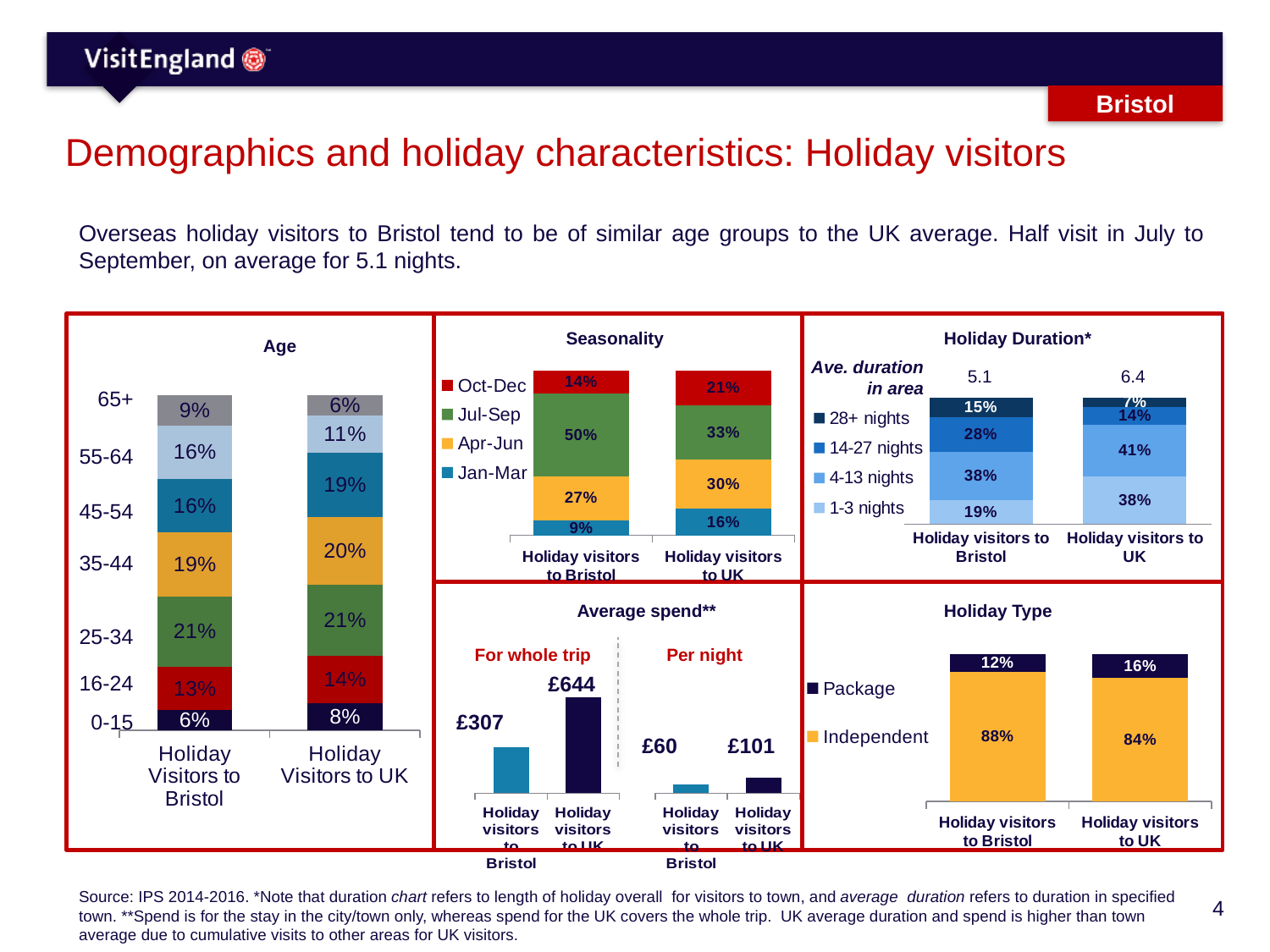
What kind of chart is the Average spend chart? Bar chart How many age groups are shown in the Age chart? 7 In the Holiday Duration chart, what is the average duration in area for holiday visitors to Bristol? 5.1 In the Average spend chart, what is the spend for the whole trip for holiday visitors to UK? £644 In the Holiday Duration chart, which is larger: the share of 1-3 nights for holiday visitors to Bristol or for holiday visitors to UK? Holiday visitors to UK In the Age chart, which age group has the smallest share among holiday visitors to Bristol? 0-15 How many series does the legend of the Holiday Duration chart list? 4 In the Seasonality chart, which season has the largest share for holiday visitors to Bristol? Jul-Sep In the Holiday Type chart, what percentage of holiday visitors to Bristol take a package holiday? 12% In the Average spend chart, what is the difference in per night spend between holiday visitors to UK and holiday visitors to Bristol? £41 In the Seasonality chart, what share of holiday visitors to Bristol visit in Jul-Sep? 50% In the Age chart, what percentage of holiday visitors to Bristol are aged 25-34? 21%